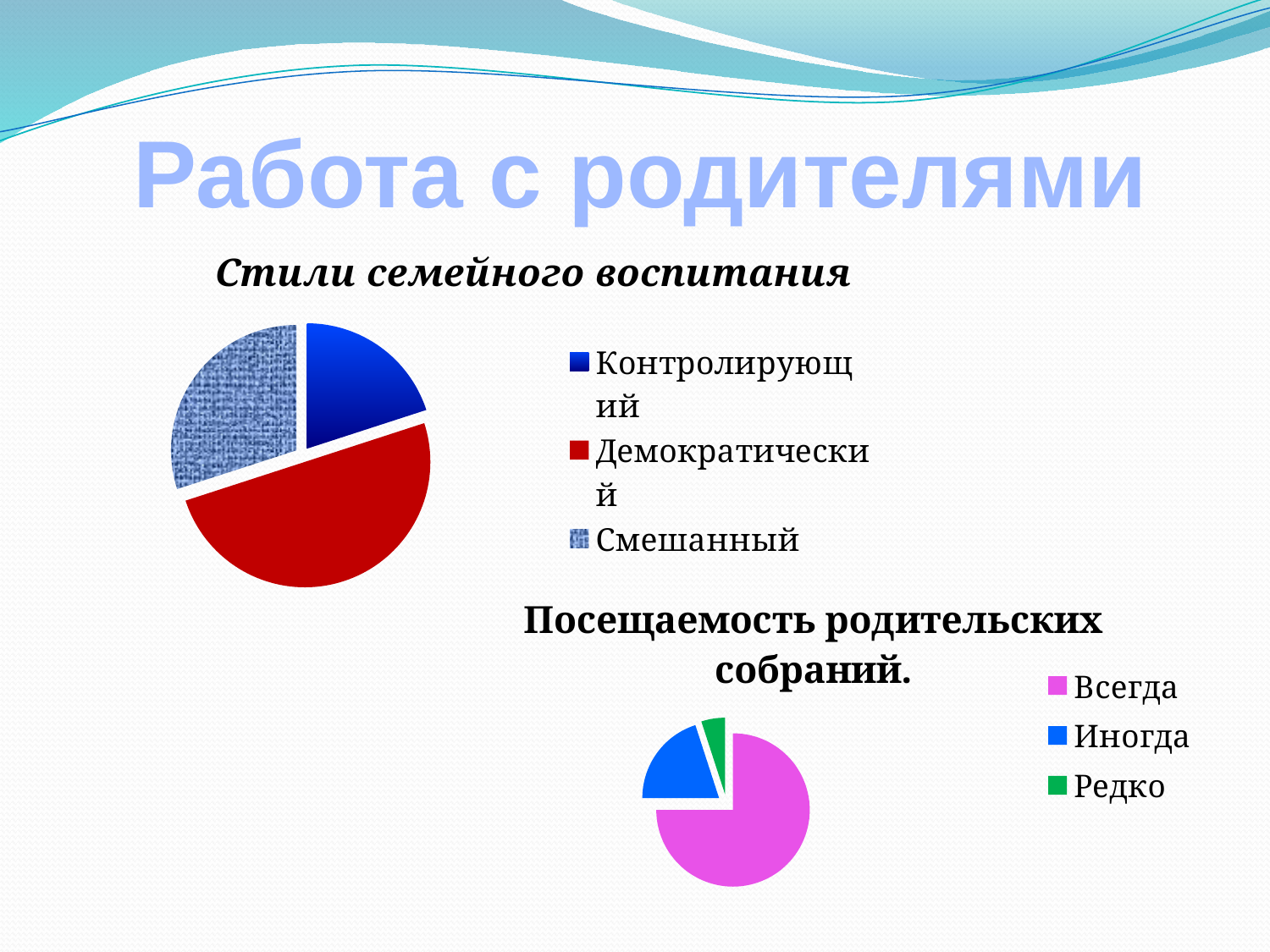
In the "Посещаемость родительских собраний" chart, what colour is the Редко slice? green In the "Посещаемость родительских собраний" chart, which category has the largest slice? Всегда In the "Стили семейного воспитания" chart, which slice is larger: Демократический or Контролирующий? Демократический In the "Стили семейного воспитания" chart, what colour is the Демократический slice? red In the "Посещаемость родительских собраний" chart, how many categories does the legend list? 3 What kind of chart is the "Стили семейного воспитания" chart? pie chart What kind of chart is the "Посещаемость родительских собраний" chart? pie chart In the "Стили семейного воспитания" chart, how many slices does the pie have? 3 In the "Посещаемость родительских собраний" chart, which slice is larger: Иногда or Редко? Иногда In the "Посещаемость родительских собраний" chart, which slice is larger: Всегда or Иногда? Всегда In the "Посещаемость родительских собраний" chart, which category has the smallest slice? Редко In the "Стили семейного воспитания" chart, which category has the largest slice? Демократический